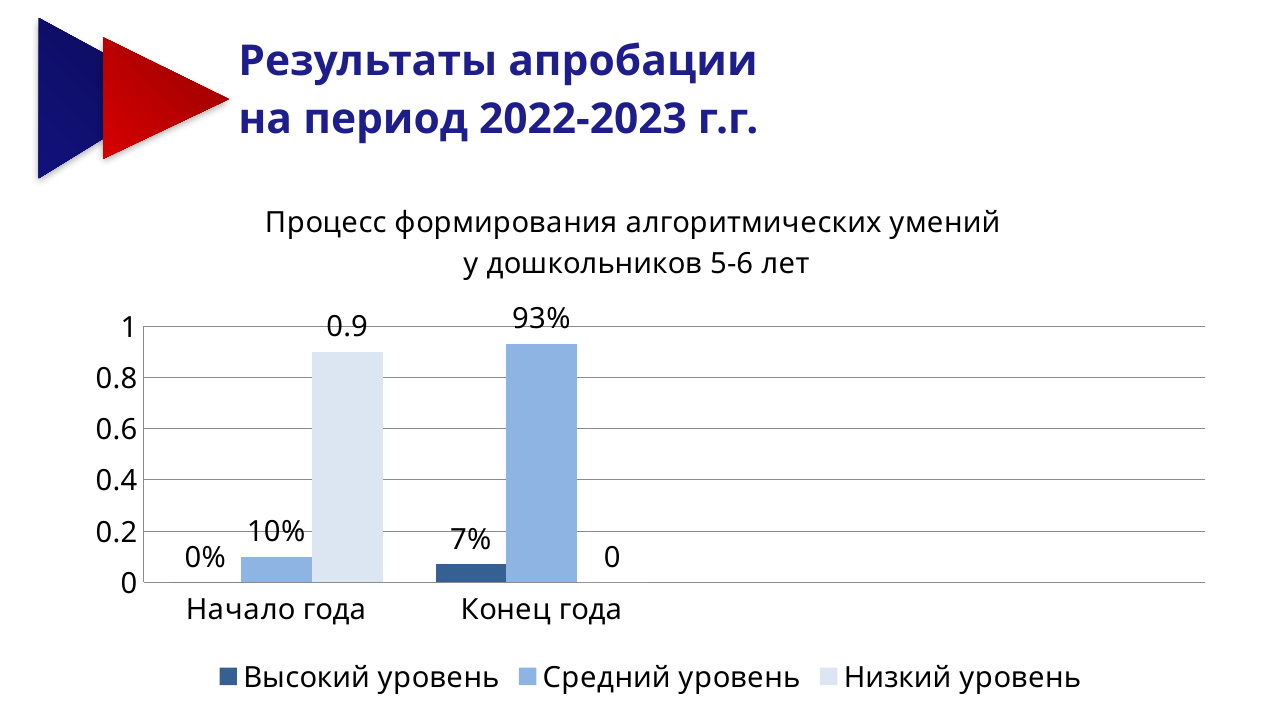
For Средний уровень, which category has the larger value, Начало года or Конец года? Конец года What is the value for Средний уровень at Конец года? 93% Which series has the highest value at Начало года? Низкий уровень What is the value for Низкий уровень at Начало года? 0.9 How many categories are shown on the x axis? 2 What is the value for Высокий уровень at Начало года? 0% What is the value for Средний уровень at Начало года? 10% Which series has the highest value at Конец года? Средний уровень What kind of chart is shown on the slide? bar chart What is the value for Высокий уровень at Конец года? 7% Is the value for Низкий уровень at Начало года greater or less than 0.8? greater How many series does the legend list? 3